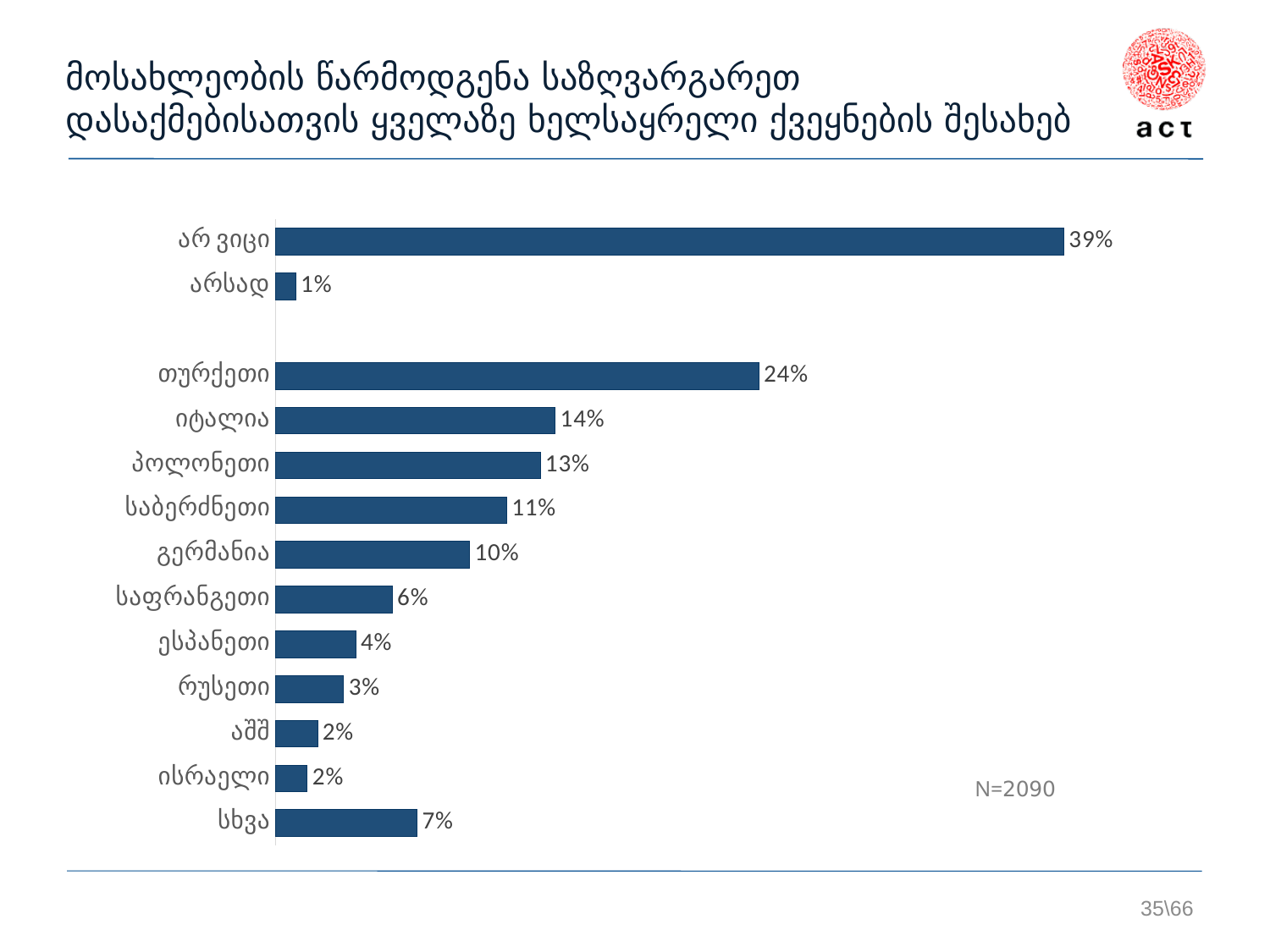
What sample size (N) is shown on the slide? N=2090 How many bars are shown in the chart? 13 What is the value for სხვა? 7% What is the value for გერმანია? 10% What is the difference between the values for არ ვიცი and თურქეთი? 15% Which category has the highest value? არ ვიცი What is the value for თურქეთი? 24% Which is larger, the value for პოლონეთი or the value for საბერძნეთი? პოლონეთი Which category has the lowest value? არსად What is the difference between the values for თურქეთი and იტალია? 10% What kind of chart is shown on the slide? Bar chart What is the value for იტალია? 14%